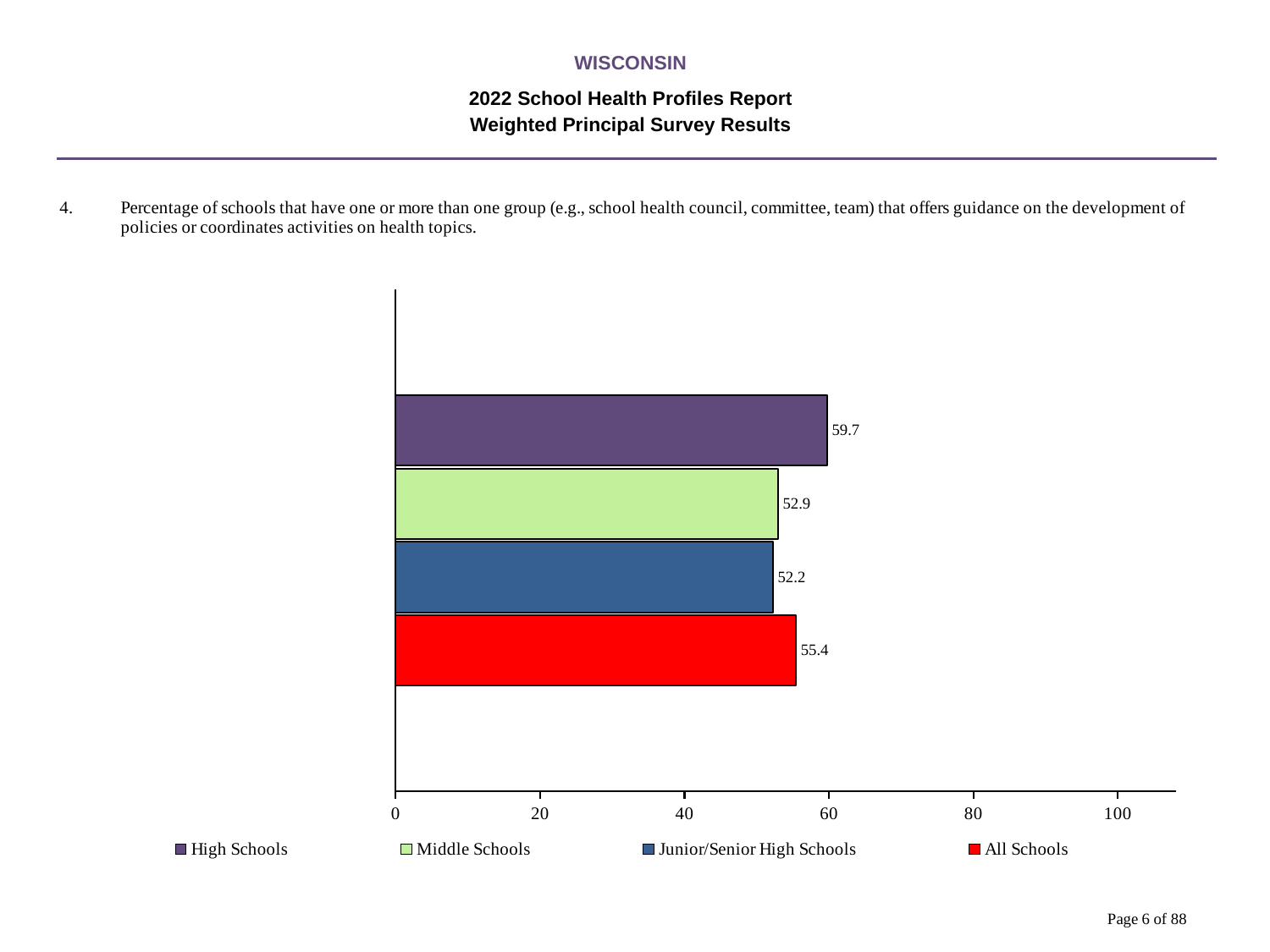
Which school type has the lowest value? Junior/Senior High Schools Which is larger, the value for High Schools or the value for Middle Schools? High Schools What is the value for Junior/Senior High Schools? 52.2 What kind of chart is shown on the slide? bar chart What is the difference between the values for High Schools and All Schools? 4.3 What is the value for All Schools? 55.4 What is the value for High Schools? 59.7 What is the value for Middle Schools? 52.9 Is the value for All Schools greater or less than 60? less How many entries does the legend list? 4 How many bars are plotted on the chart? 4 Which school type has the highest value? High Schools